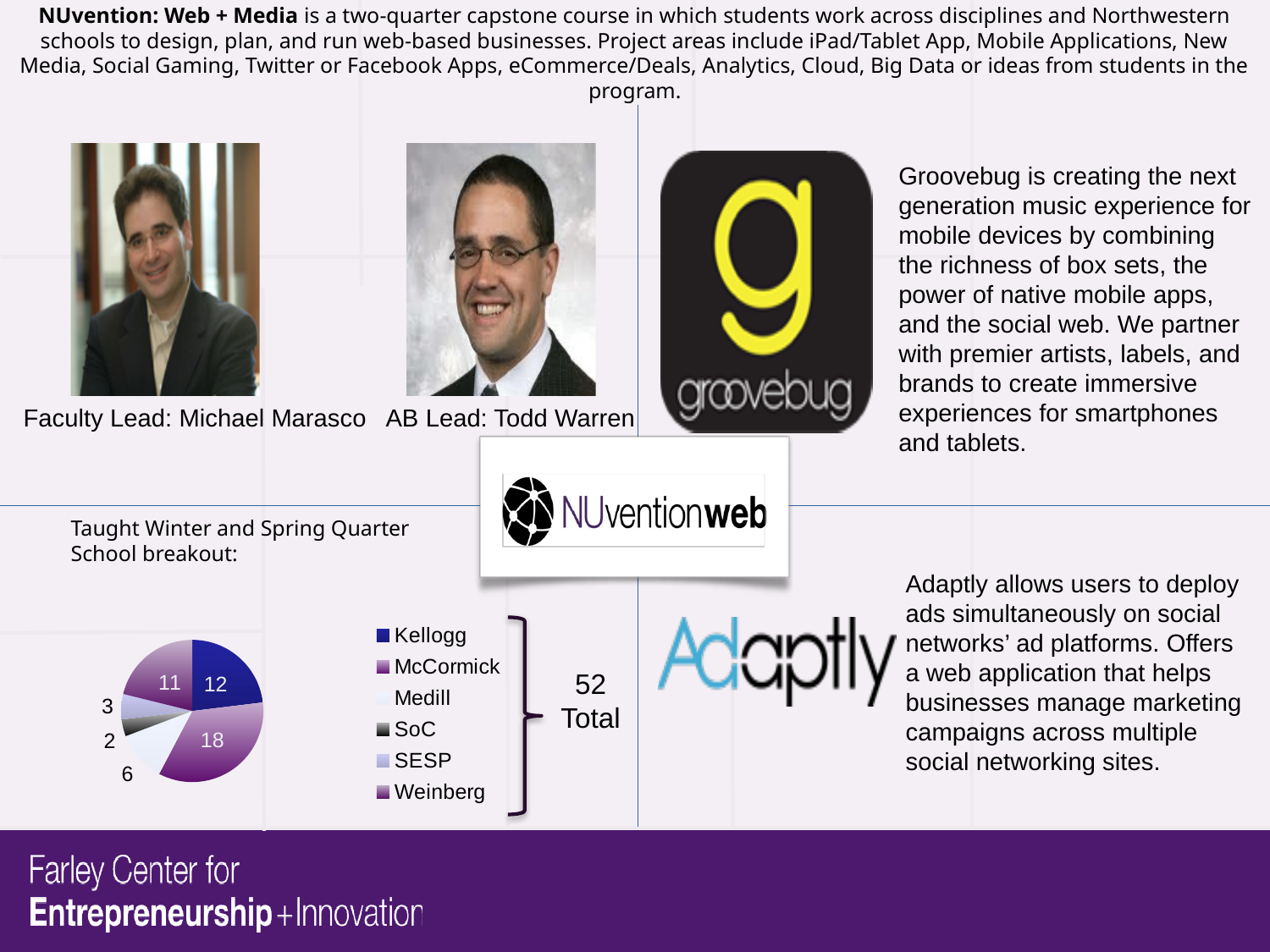
How many slices does the school breakout pie chart have? 6 What is the value for SESP in the school breakout pie chart? 3 What kind of chart is used to show the school breakout? pie chart Which school has the largest slice in the school breakout pie chart? McCormick Which school has the smallest slice in the school breakout pie chart? SoC What is the value for McCormick in the school breakout pie chart? 18 In the school breakout pie chart, which is larger, Weinberg or Medill? Weinberg What is the difference between the McCormick and Kellogg values in the school breakout pie chart? 6 What is the total of all slices in the school breakout pie chart? 52 What is the value for Medill in the school breakout pie chart? 6 What is the value for Kellogg in the school breakout pie chart? 12 How many schools does the legend of the school breakout pie chart list? 6